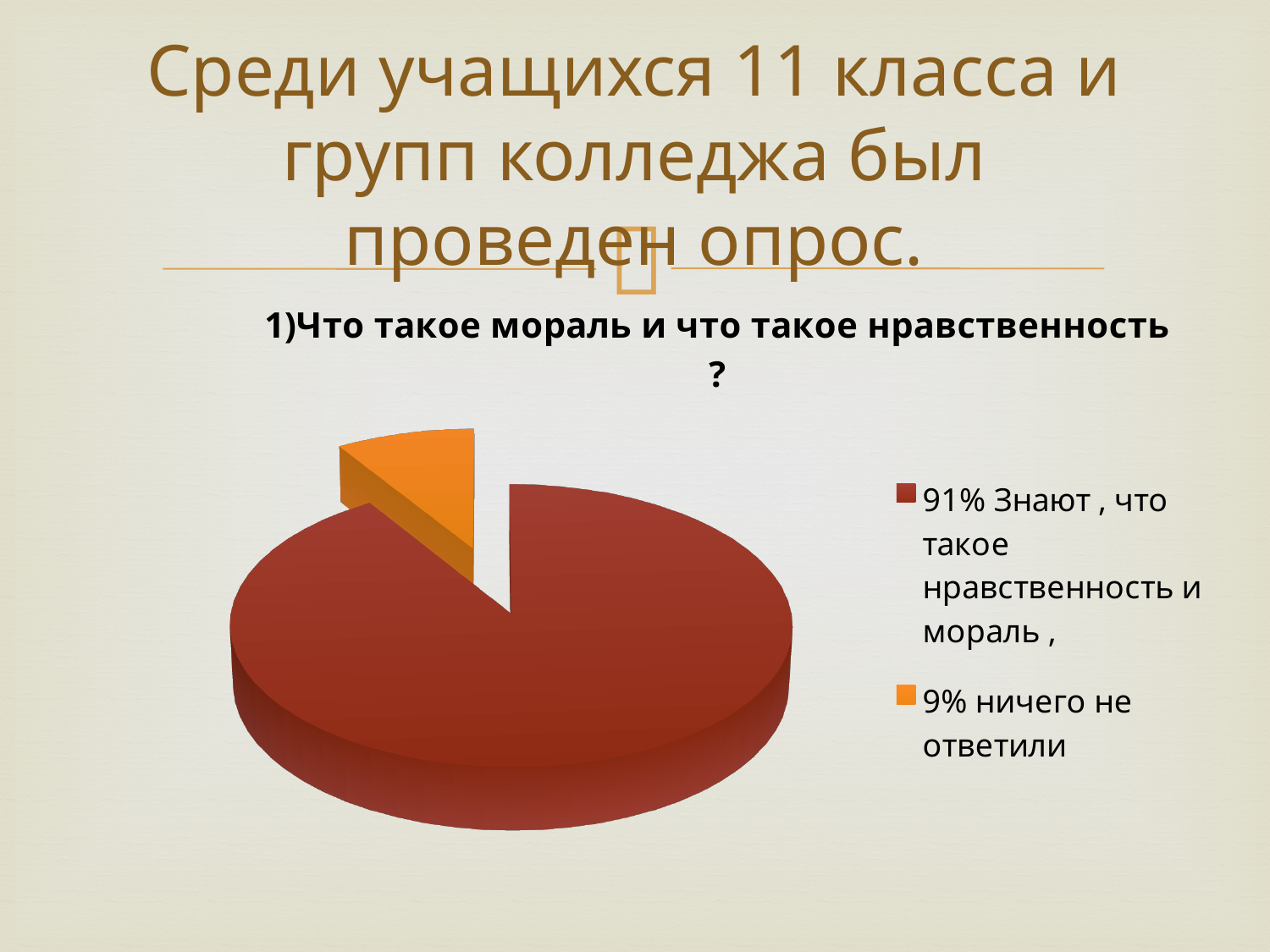
How many entries does the legend of the pie chart list? 2 Which slice of the pie chart is the smallest? 9% ничего не ответили What is the difference in percentage points between the share who know what morality and ethics are and the share who did not answer? 82 What kind of chart is shown on the slide? pie chart What share of respondents know what morality and ethics are ("Знают, что такое нравственность и мораль")? 91% Which is larger: the share who know what morality and ethics are, or the share who did not answer? Знают, что такое нравственность и мораль Which slice of the pie chart is the largest? 91% Знают, что такое нравственность и мораль What is the title of the pie chart? 1)Что такое мораль и что такое нравственность ? What share of respondents did not answer anything ("ничего не ответили")? 9% What colour is the slice for "9% ничего не ответили"? orange How many slices does the pie chart have? 2